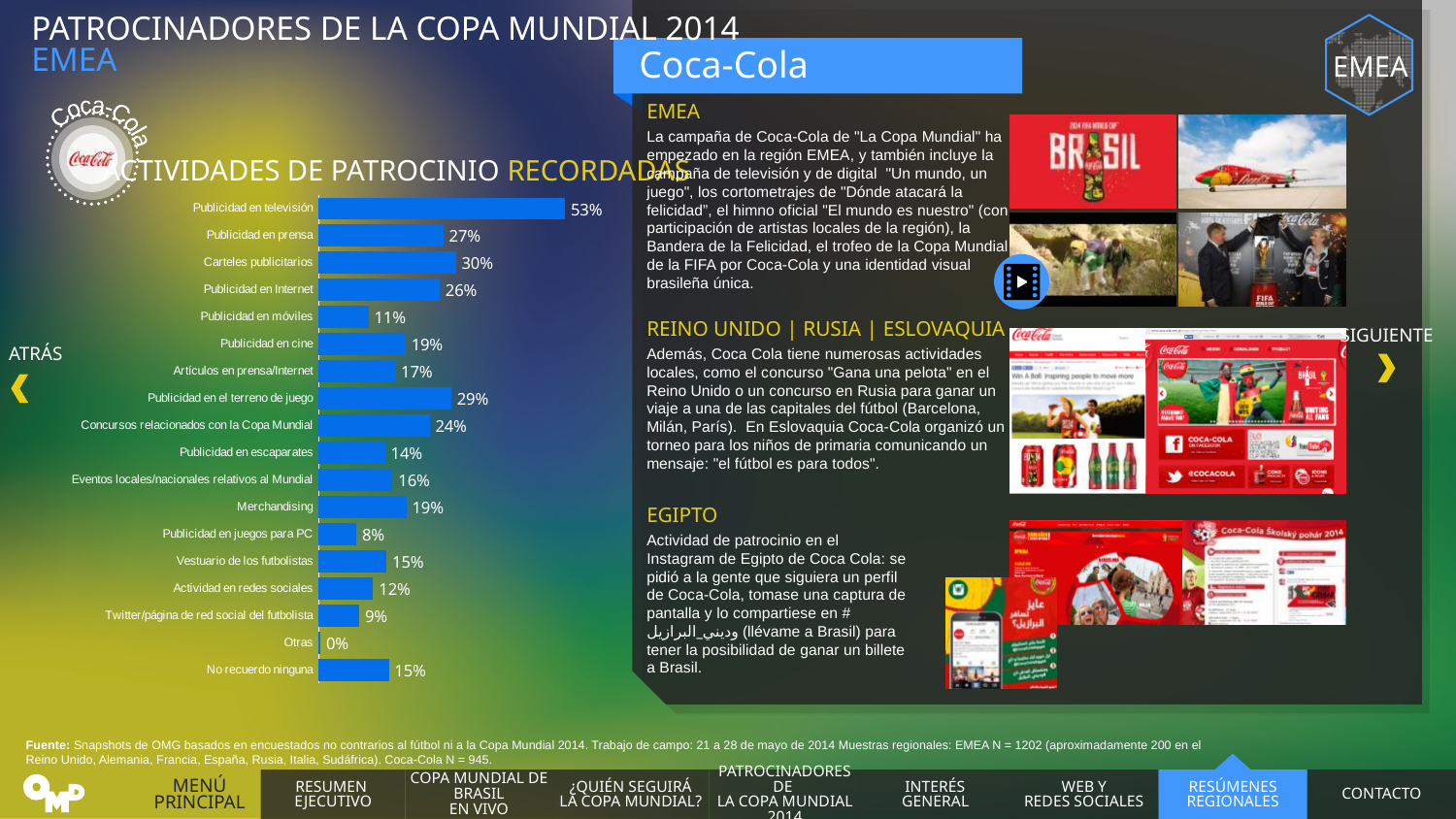
What value is shown for Carteles publicitarios? 30% Which is larger, Actividad en redes sociales or Publicidad en móviles? Actividad en redes sociales What value is shown for Publicidad en juegos para PC? 8% What kind of chart is shown on the slide? Bar chart Which is larger, Publicidad en el terreno de juego or Concursos relacionados con la Copa Mundial? Publicidad en el terreno de juego How many categories are shown in the chart? 18 What is the difference between Publicidad en televisión and Publicidad en prensa? 26% Which category has the lowest value in the chart? Otras What is the difference between Carteles publicitarios and Publicidad en Internet? 4% What value is shown for Publicidad en televisión? 53% What value is shown for No recuerdo ninguna? 15% Which category has the highest value in the chart? Publicidad en televisión